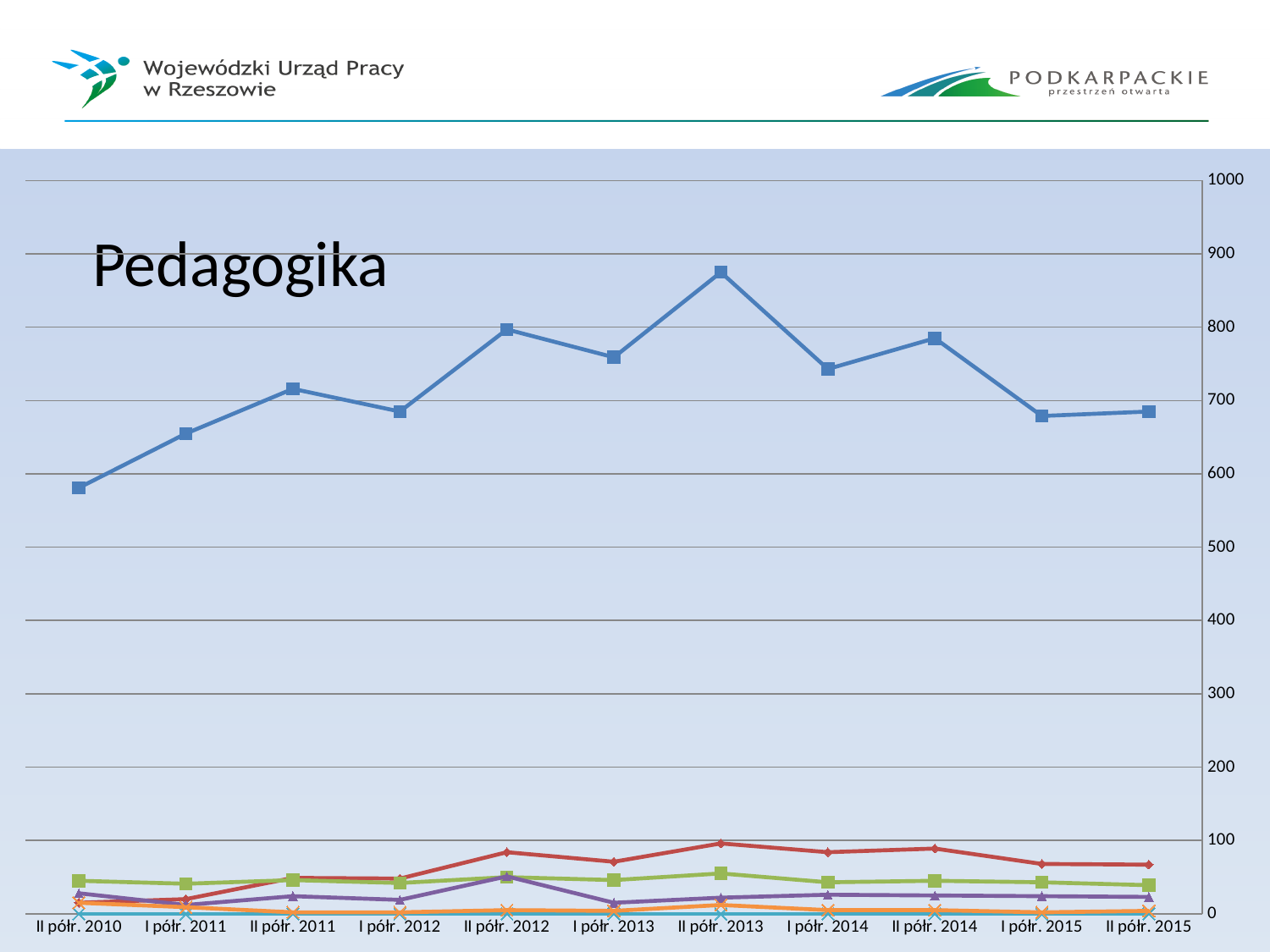
Is the value of the blue line for II półr. 2013 greater or less than 800? greater In which period does the blue line reach its highest value? II półr. 2013 How many time periods are shown on the x axis? 11 In which period does the blue line have its lowest value? II półr. 2010 For the blue line, which is larger: the value for I półr. 2014 or the value for II półr. 2014? II półr. 2014 Does the blue line rise or fall from II półr. 2010 to II półr. 2011? rise Is the value of the red line for II półr. 2010 greater or less than 100? less Is the value of the blue line for I półr. 2012 greater or less than 700? less For the blue line, which is larger: the value for II półr. 2012 or the value for I półr. 2013? II półr. 2012 What kind of chart is shown on the slide? line chart What is the title of the chart? Pedagogika